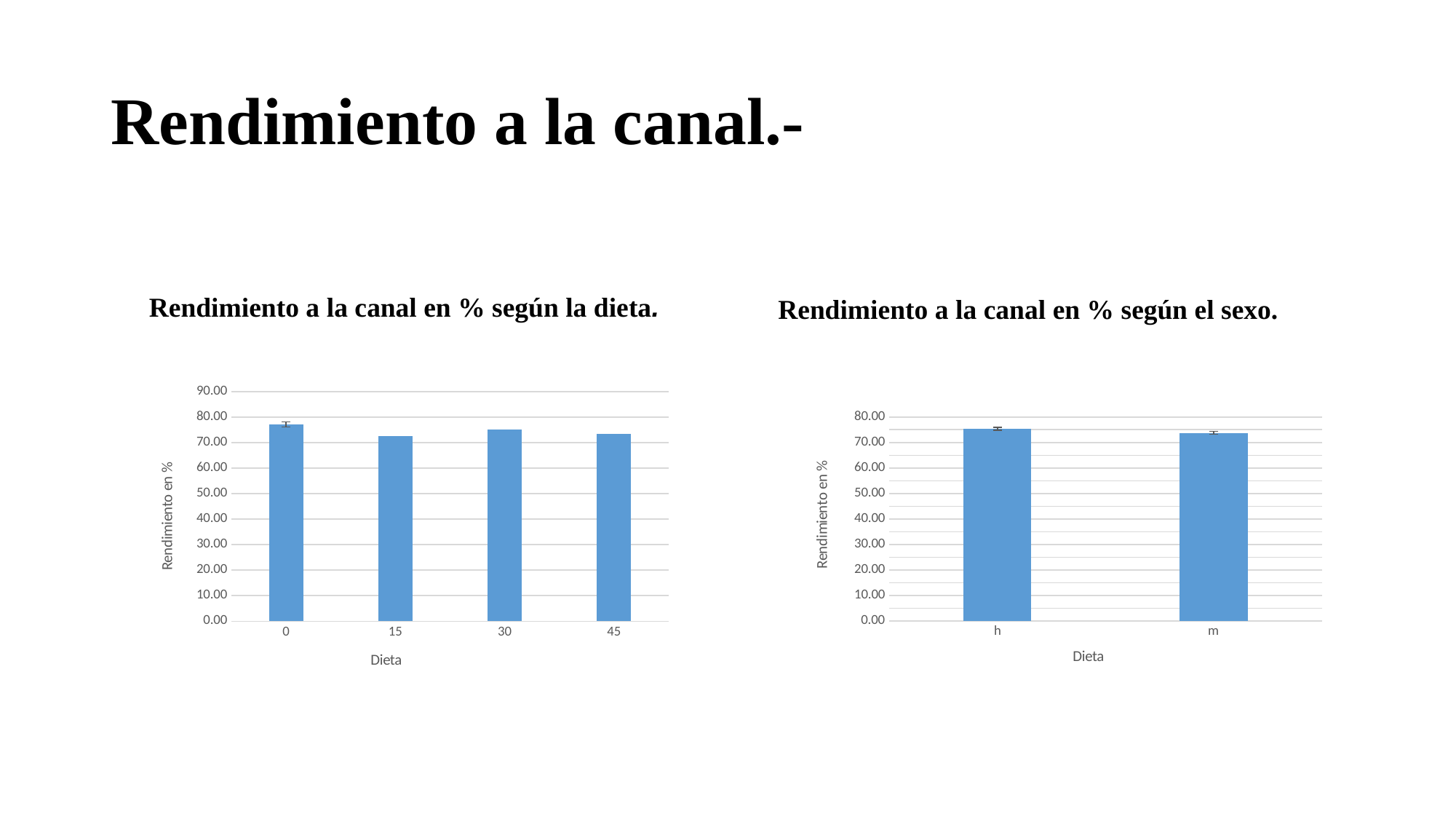
In the left chart, 'Rendimiento a la canal en % según la dieta', which diet has the highest value? 0 In the left chart, 'Rendimiento a la canal en % según la dieta', is the value for diet 15 greater or less than 80.00? less What is the x-axis label of the left chart, 'Rendimiento a la canal en % según la dieta'? Dieta What is the y-axis label of the right chart, 'Rendimiento a la canal en % según el sexo'? Rendimiento en % In the left chart, 'Rendimiento a la canal en % según la dieta', is the value for diet 0 greater or less than 70.00? greater What kind of chart is the left chart, 'Rendimiento a la canal en % según la dieta'? bar chart In the left chart, 'Rendimiento a la canal en % según la dieta', is the value for diet 45 greater or less than 70.00? greater How many categories are shown on the x axis of the left chart, 'Rendimiento a la canal en % según la dieta'? 4 In the left chart, 'Rendimiento a la canal en % según la dieta', which is larger, the value for diet 0 or diet 15? 0 How many categories are shown on the x axis of the right chart, 'Rendimiento a la canal en % según el sexo'? 2